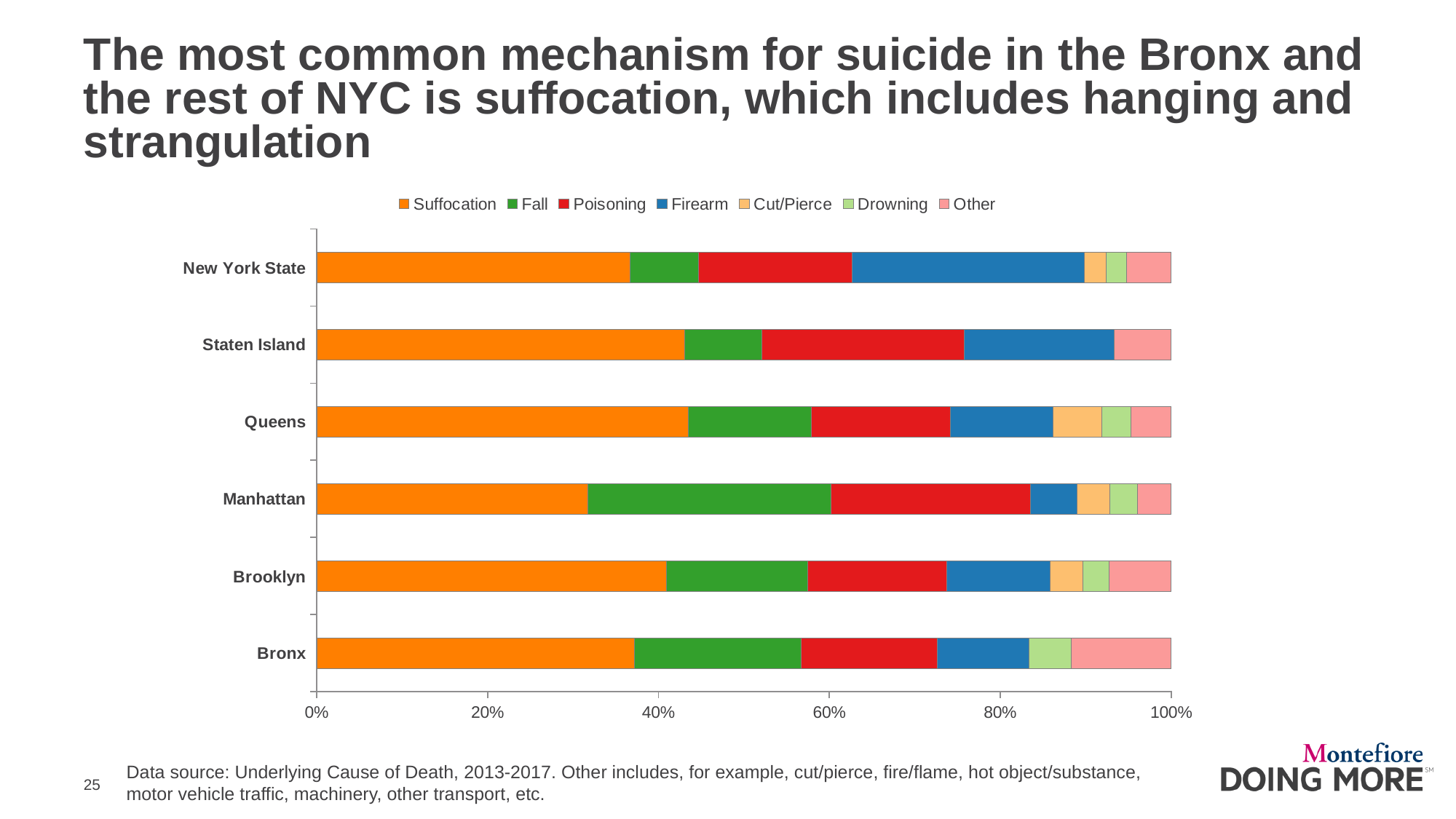
How many series does the legend list? 7 Which region's bar has no Drowning segment? Staten Island Which region has the smallest Suffocation segment? Manhattan Which region has the largest Fall segment? Manhattan Is the Suffocation share for Manhattan greater or less than 40%? less Which region has the largest Firearm segment? New York State What is the first series listed in the legend? Suffocation Is the Suffocation share for the Bronx greater or less than 40%? less What kind of chart is shown on the slide? Stacked bar chart Which has the larger Fall segment, Manhattan or the Bronx? Manhattan How many categories (regions) are plotted on the y axis? 6 Is the Suffocation share for Staten Island greater or less than 40%? greater